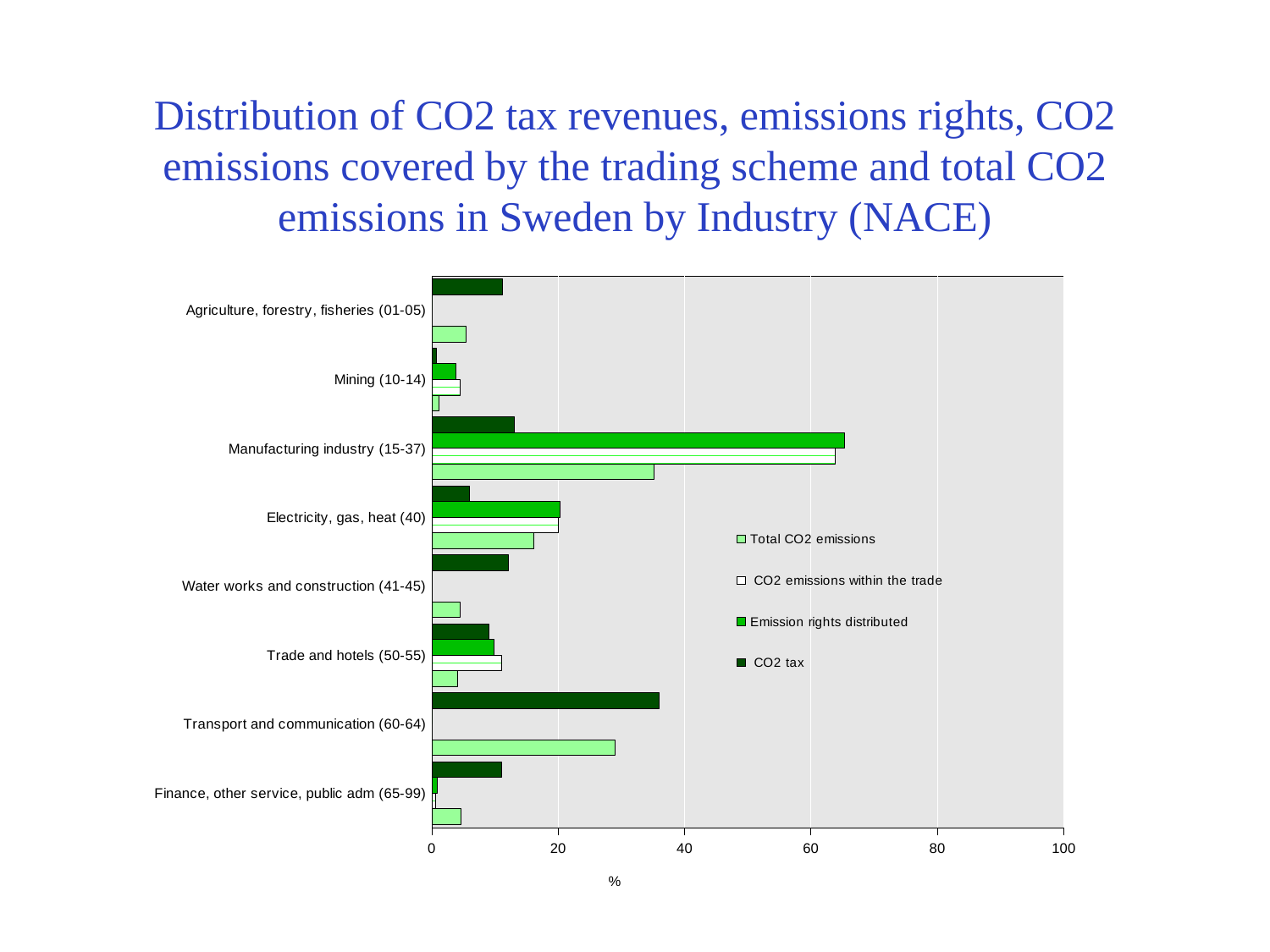
Is the value for Emission rights distributed in Manufacturing industry (15-37) greater or less than 60? greater How many series does the legend list? 4 Is the value for CO2 tax in Transport and communication (60-64) greater or less than 40? less What unit is shown on the horizontal axis label? % What kind of chart is shown on the slide? bar chart Which industry has the highest value for CO2 tax? Transport and communication (60-64) Which is larger for Manufacturing industry (15-37): Emission rights distributed or CO2 tax? Emission rights distributed Which industry has the highest value for Emission rights distributed? Manufacturing industry (15-37) Which industry has the highest value for Total CO2 emissions? Manufacturing industry (15-37) How many industry categories are shown on the chart? 8 Is the value for Total CO2 emissions in Electricity, gas, heat (40) greater or less than 20? less Which is larger for Transport and communication (60-64): CO2 tax or Total CO2 emissions? CO2 tax